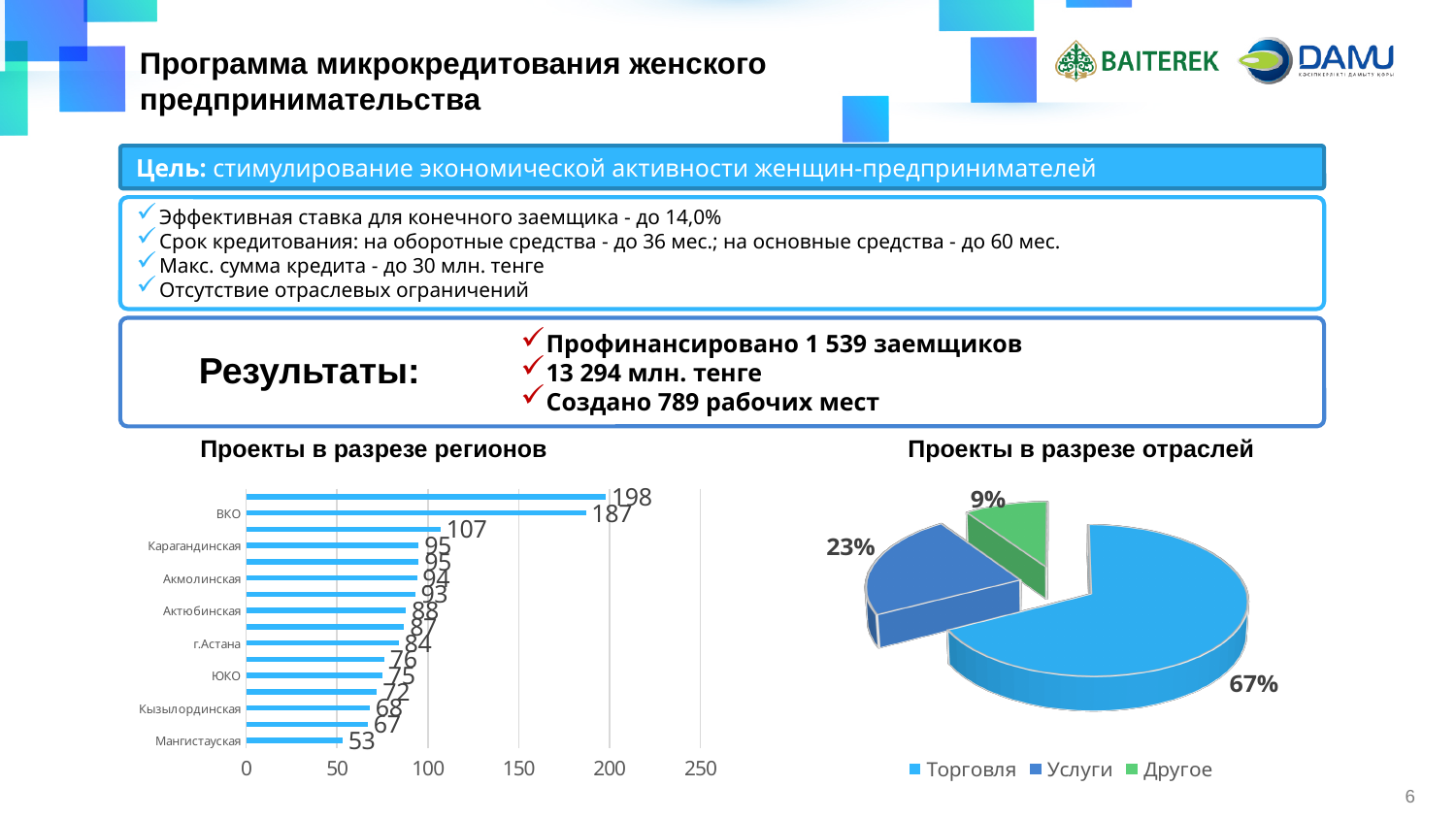
In the 'Проекты в разрезе отраслей' chart, which category has the largest share? Торговля In the 'Проекты в разрезе отраслей' chart, what share does Другое have? 9% In the 'Проекты в разрезе отраслей' chart, what share does Услуги have? 23% In the 'Проекты в разрезе регионов' chart, is the value for Мангистауская greater or less than 100? less In the 'Проекты в разрезе отраслей' chart, how many percentage points larger is Торговля than Услуги? 44 What type of chart is 'Проекты в разрезе регионов'? bar chart What type of chart is 'Проекты в разрезе отраслей'? pie chart In the 'Проекты в разрезе регионов' chart, what is the value for Мангистауская? 53 In the 'Проекты в разрезе регионов' chart, what is the value for ВКО? 187 In the 'Проекты в разрезе отраслей' chart, which category has the smallest share? Другое In the 'Проекты в разрезе отраслей' chart, what share does Торговля have? 67% How many categories does the legend of the 'Проекты в разрезе отраслей' chart list? 3